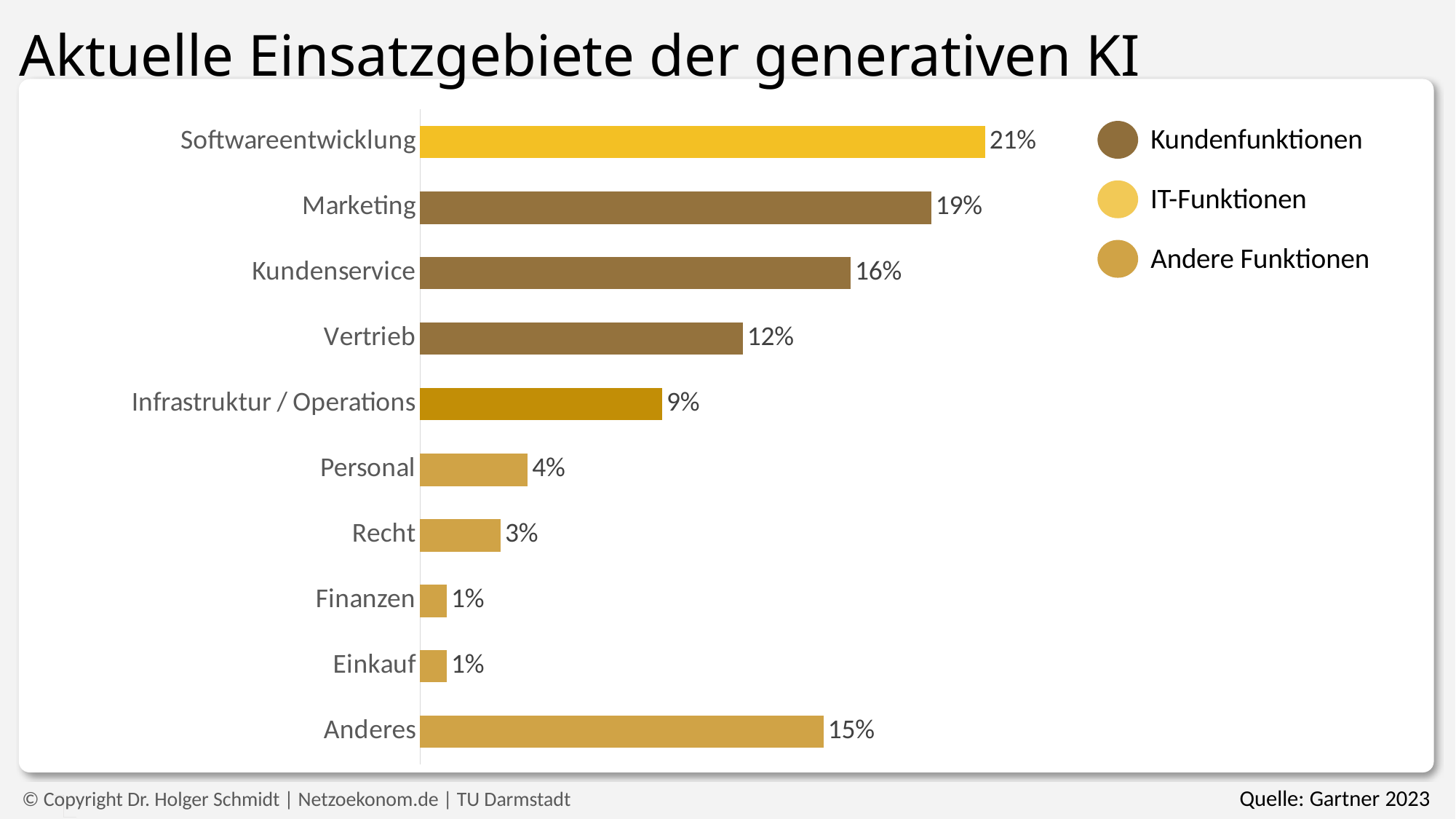
Which category has the highest value? Softwareentwicklung How many entries does the legend list? 3 What is the difference between the values for Softwareentwicklung and Anderes? 6% Which legend entry is shown in the darkest brown colour? Kundenfunktionen What is the value for Kundenservice? 16% What kind of chart is shown on the slide? Bar chart Which is larger, the value for Infrastruktur / Operations or the value for Personal? Infrastruktur / Operations How many categories are shown in the chart? 10 What is the value for Anderes? 15% What is the value for Softwareentwicklung? 21% What is the difference between the values for Marketing and Vertrieb? 7% What is the title of the slide? Aktuelle Einsatzgebiete der generativen KI